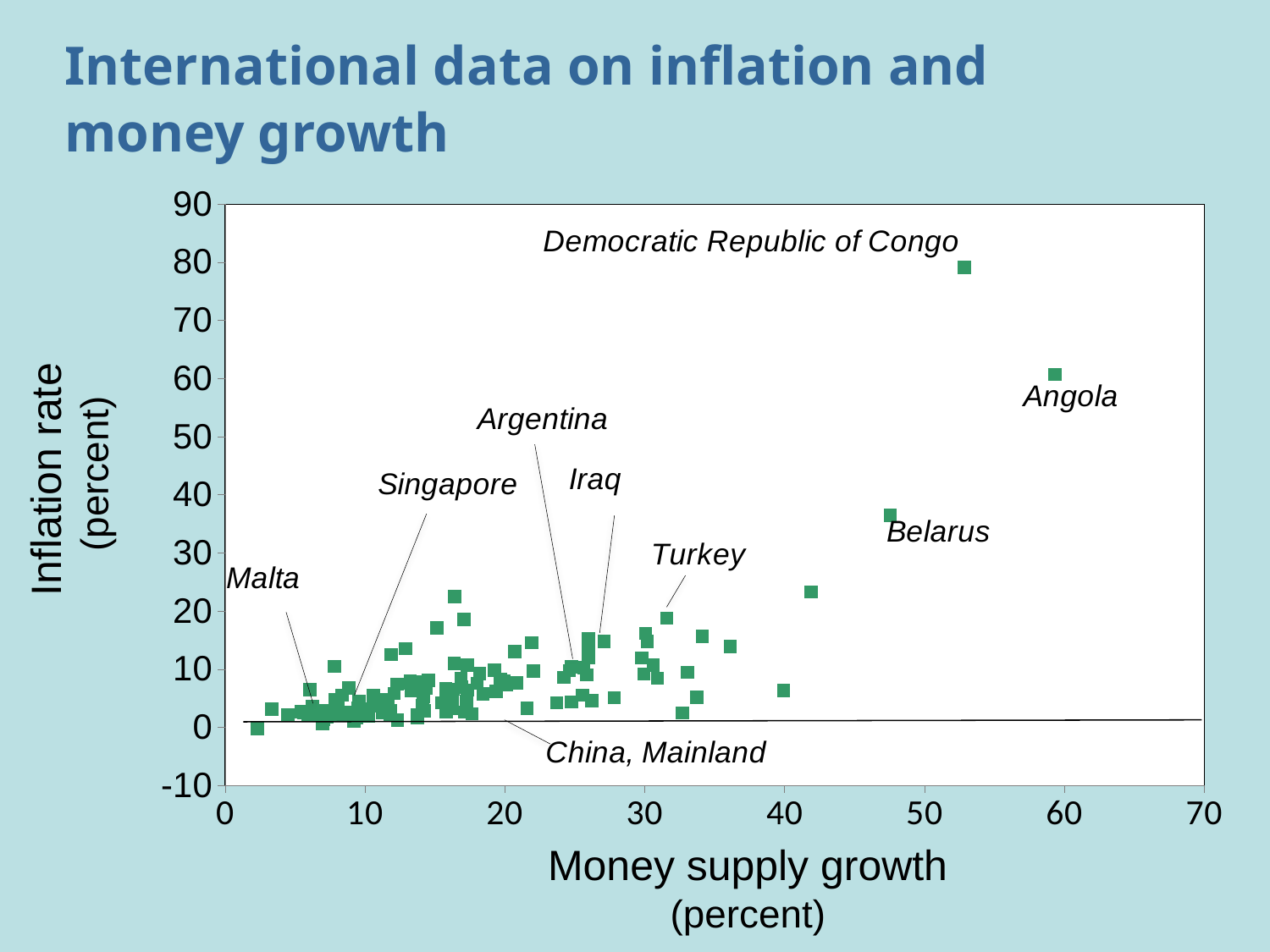
Which labeled country has the highest money supply growth? Angola What is the title of the chart on the slide? International data on inflation and money growth Is the inflation rate for Belarus greater or less than 30? greater Which has the higher inflation rate, Belarus or Turkey? Belarus Is the inflation rate for Angola greater or less than 50? greater Which labeled country has the highest inflation rate? Democratic Republic of Congo What variable is plotted on the horizontal axis? Money supply growth (percent) Is the inflation rate for Malta greater or less than 10? less What kind of chart is shown on the slide? scatter plot Do inflation rates generally rise or fall as money supply growth increases? rise